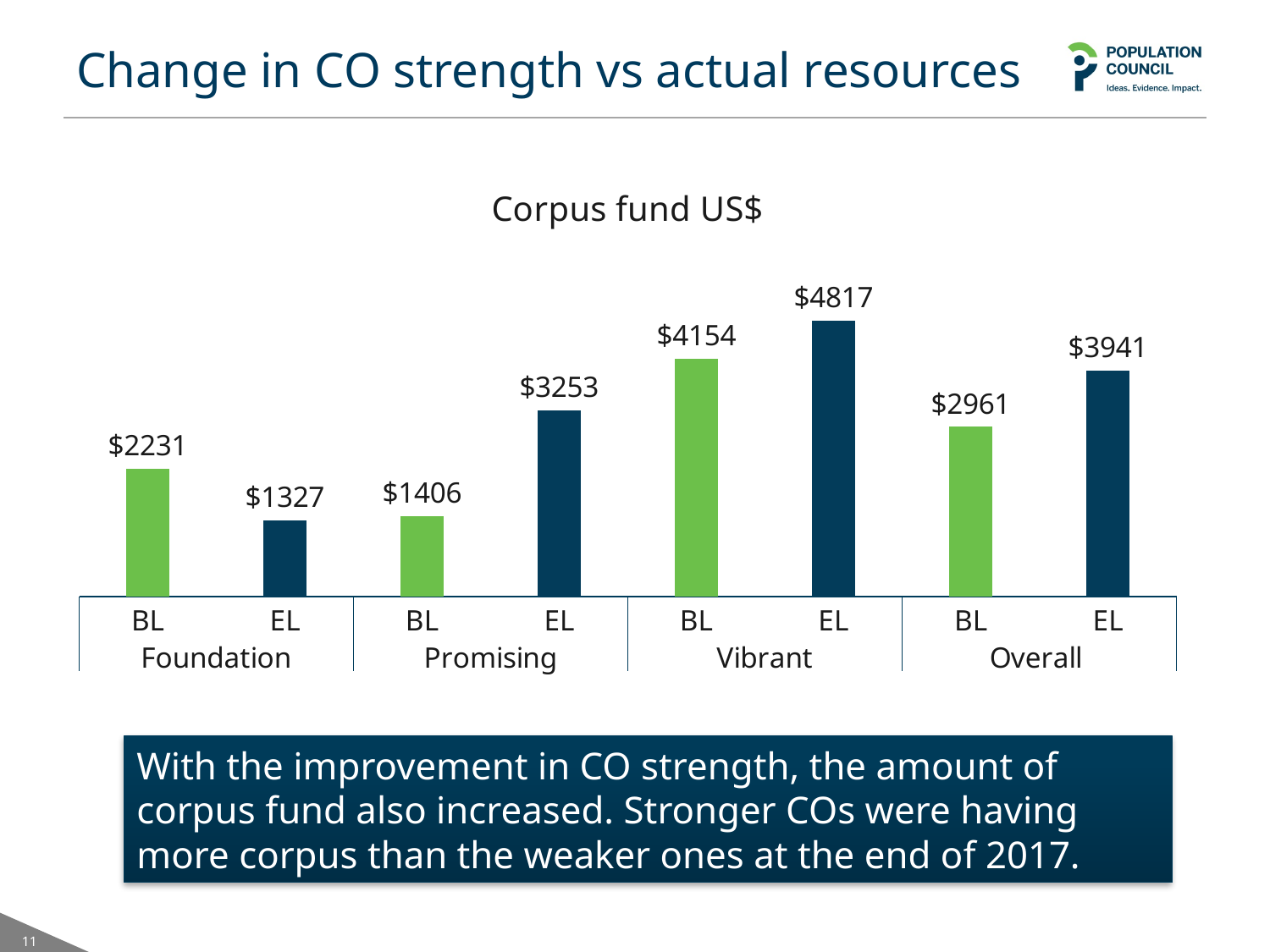
What kind of chart is shown on the slide? Bar chart What is the corpus fund value for EL in the Overall group? $3941 Which bar has the lowest corpus fund value? Foundation EL What is the corpus fund value for BL in the Foundation group? $2231 What is the difference between the EL and BL corpus fund values in the Overall group? $980 Which bar has the highest corpus fund value? Vibrant EL What is the difference between the EL and BL corpus fund values in the Promising group? $1847 What is the corpus fund value for BL in the Promising group? $1406 How many bars are plotted in the chart? 8 What is the corpus fund value for EL in the Vibrant group? $4817 Which is larger, the BL value for Foundation or the EL value for Foundation? BL What is the title of the chart? Corpus fund US$